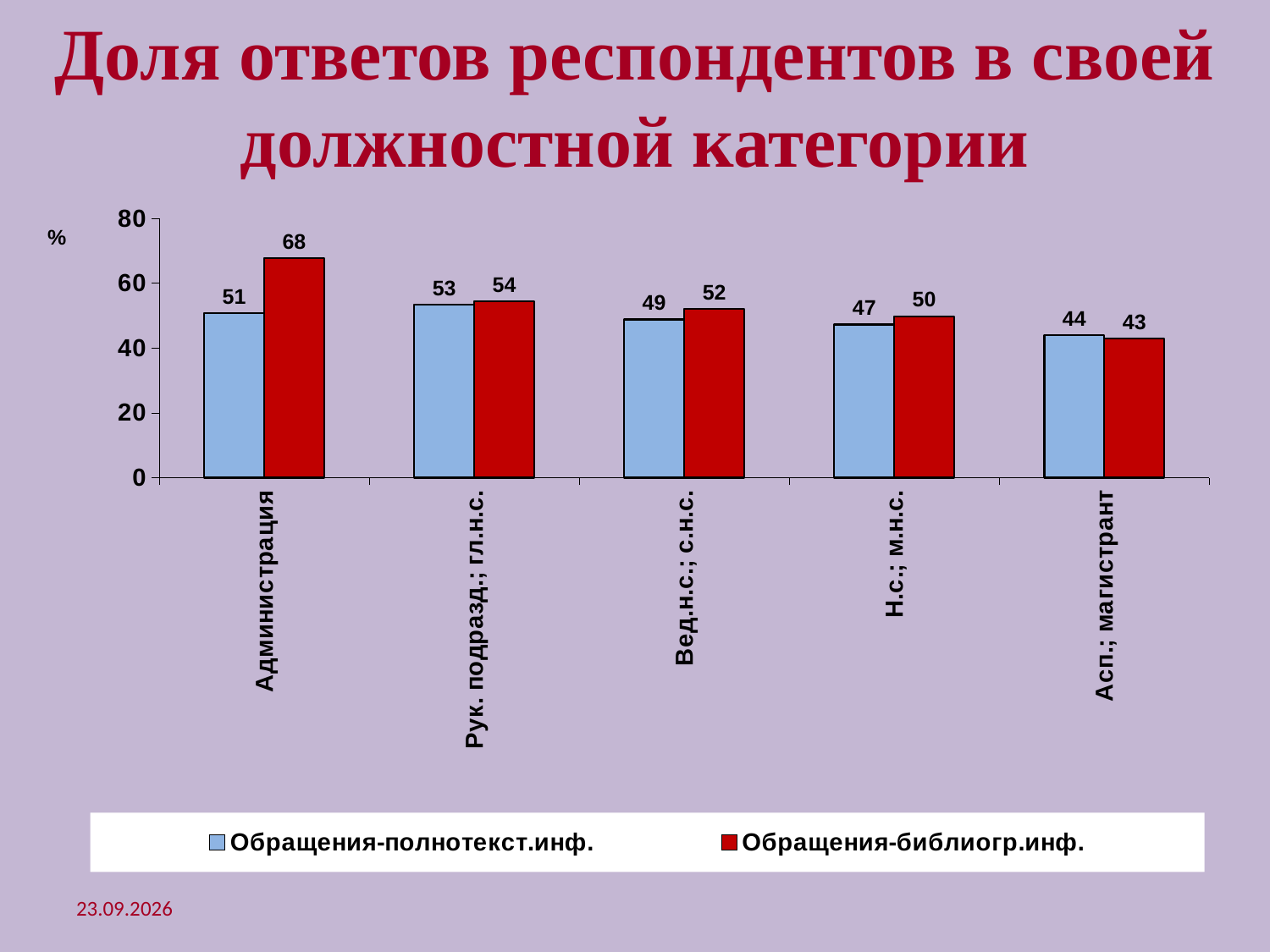
How many categories are shown on the x axis? 5 Which category has the highest value in the Обращения-библиогр.инф. series? Администрация Which category has the lowest value in the Обращения-полнотекст.инф. series? Асп.; магистрант How many series does the legend list? 2 What is the difference between the two series for Администрация? 17 What colour are the bars for the Обращения-библиогр.инф. series? red What kind of chart is shown on the slide? bar chart What is the value for Н.с.; м.н.с. in the Обращения-библиогр.инф. series? 50 What is the value for Администрация in the Обращения-библиогр.инф. series? 68 Is the value for Вед.н.с.; с.н.с. in the Обращения-полнотекст.инф. series greater or less than 60? less For Асп.; магистрант, which series has the larger value? Обращения-полнотекст.инф. What is the value for Асп.; магистрант in the Обращения-полнотекст.инф. series? 44